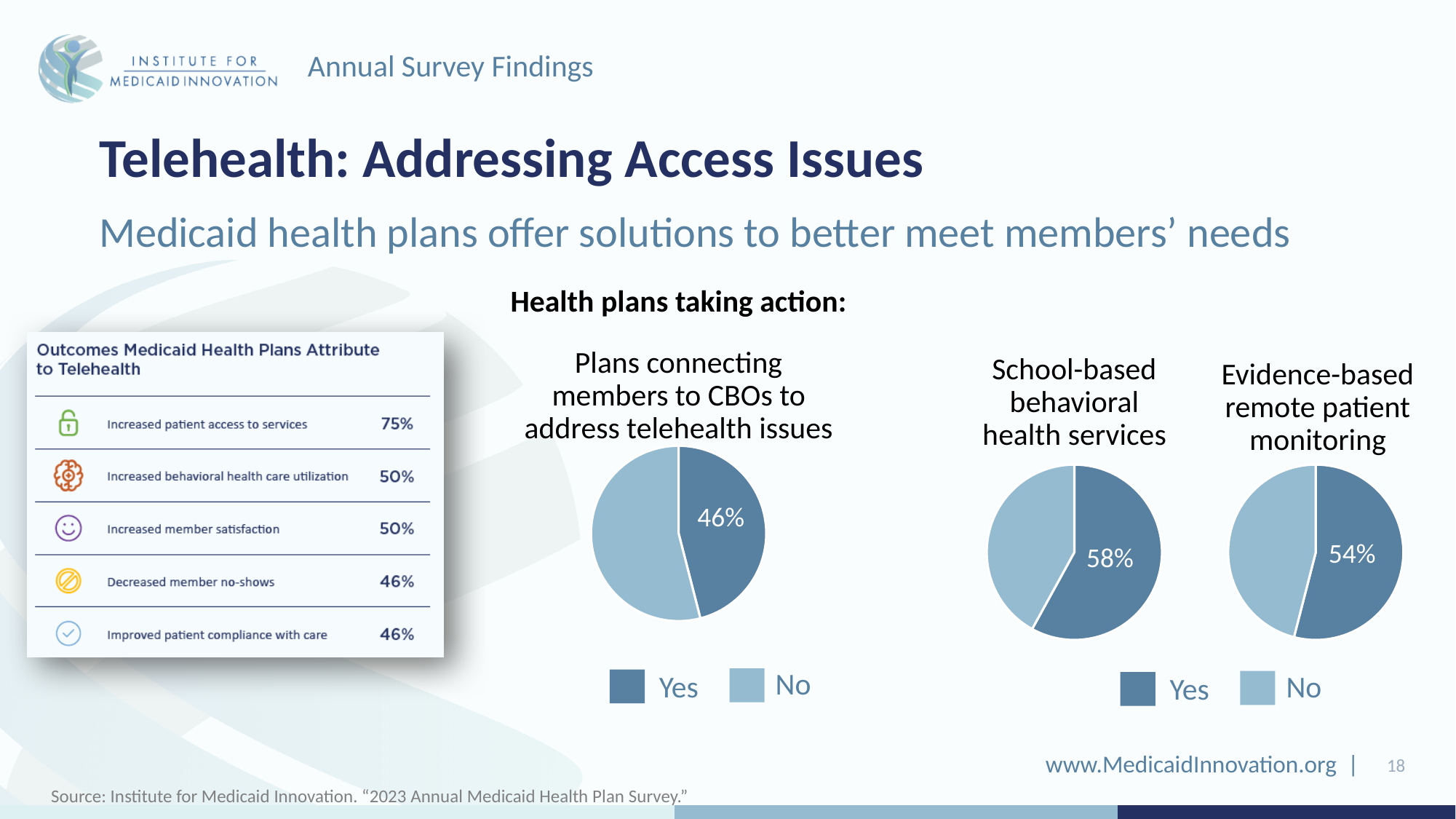
Which pie chart shows the lowest Yes percentage: 'Plans connecting members to CBOs', 'School-based behavioral health services', or 'Evidence-based remote patient monitoring'? Plans connecting members to CBOs to address telehealth issues In the pie charts, which colour represents 'Yes'? Dark blue What is the difference in percentage points between the Yes share in the 'School-based behavioral health services' pie chart and the Yes share in the 'Plans connecting members to CBOs' pie chart? 12 percentage points In the pie chart titled 'Evidence-based remote patient monitoring', what percentage of plans answered Yes? 54% Which pie chart shows the highest Yes percentage: 'Plans connecting members to CBOs', 'School-based behavioral health services', or 'Evidence-based remote patient monitoring'? School-based behavioral health services In the pie chart titled 'School-based behavioral health services', what percentage of plans answered Yes? 58% How many entries does the legend below the pie charts list? 2 In the pie chart titled 'Plans connecting members to CBOs to address telehealth issues', what percentage of plans answered Yes? 46% In the pie chart titled 'Plans connecting members to CBOs to address telehealth issues', is the Yes slice or the No slice larger? No Is the Yes percentage larger in the 'School-based behavioral health services' pie chart or the 'Evidence-based remote patient monitoring' pie chart? School-based behavioral health services What type of chart is used under 'Health plans taking action:'? Pie chart How many pie charts are shown on the slide? 3